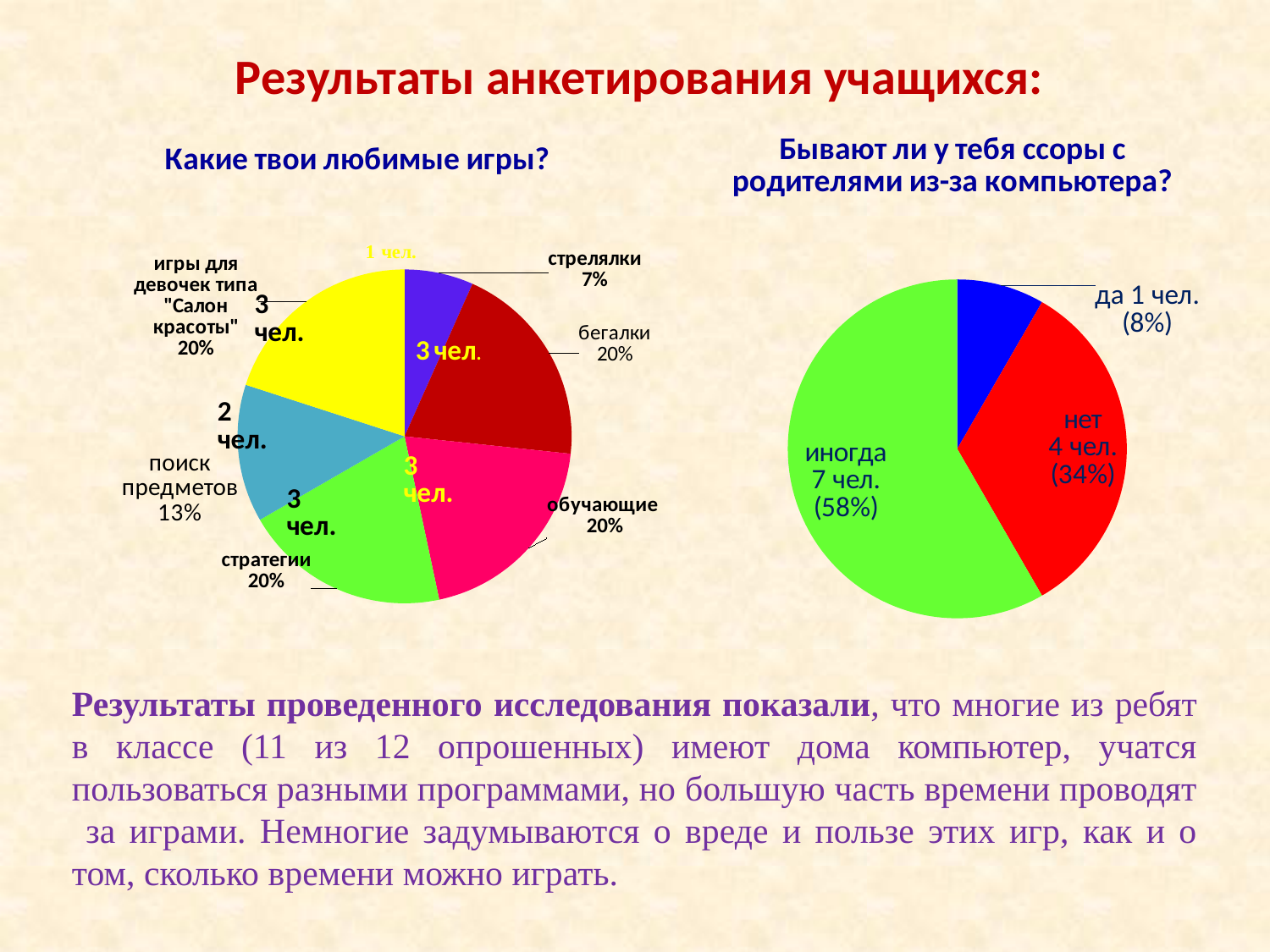
In the chart "Бывают ли у тебя ссоры с родителями из-за компьютера?", which answer has the largest share? иногда In the chart "Какие твои любимые игры?", what percentage is shown for стрелялки? 7% In the chart "Бывают ли у тебя ссоры с родителями из-за компьютера?", what colour is the slice for да? blue In the chart "Бывают ли у тебя ссоры с родителями из-за компьютера?", how many more people answered нет than да? 3 In the chart "Бывают ли у тебя ссоры с родителями из-за компьютера?", what share of the pie is нет? 34% In the chart "Бывают ли у тебя ссоры с родителями из-за компьютера?", how many people answered иногда? 7 чел. In the chart "Какие твои любимые игры?", what percentage is shown for поиск предметов? 13% What type of chart is used for "Какие твои любимые игры?"? pie chart How many slices does the pie chart "Какие твои любимые игры?" have? 6 In the chart "Какие твои любимые игры?", which category has the smallest share? стрелялки In the chart "Какие твои любимые игры?", which is larger: поиск предметов or стратегии? стратегии In the chart "Какие твои любимые игры?", what is the difference in percentage points between бегалки and стрелялки? 13